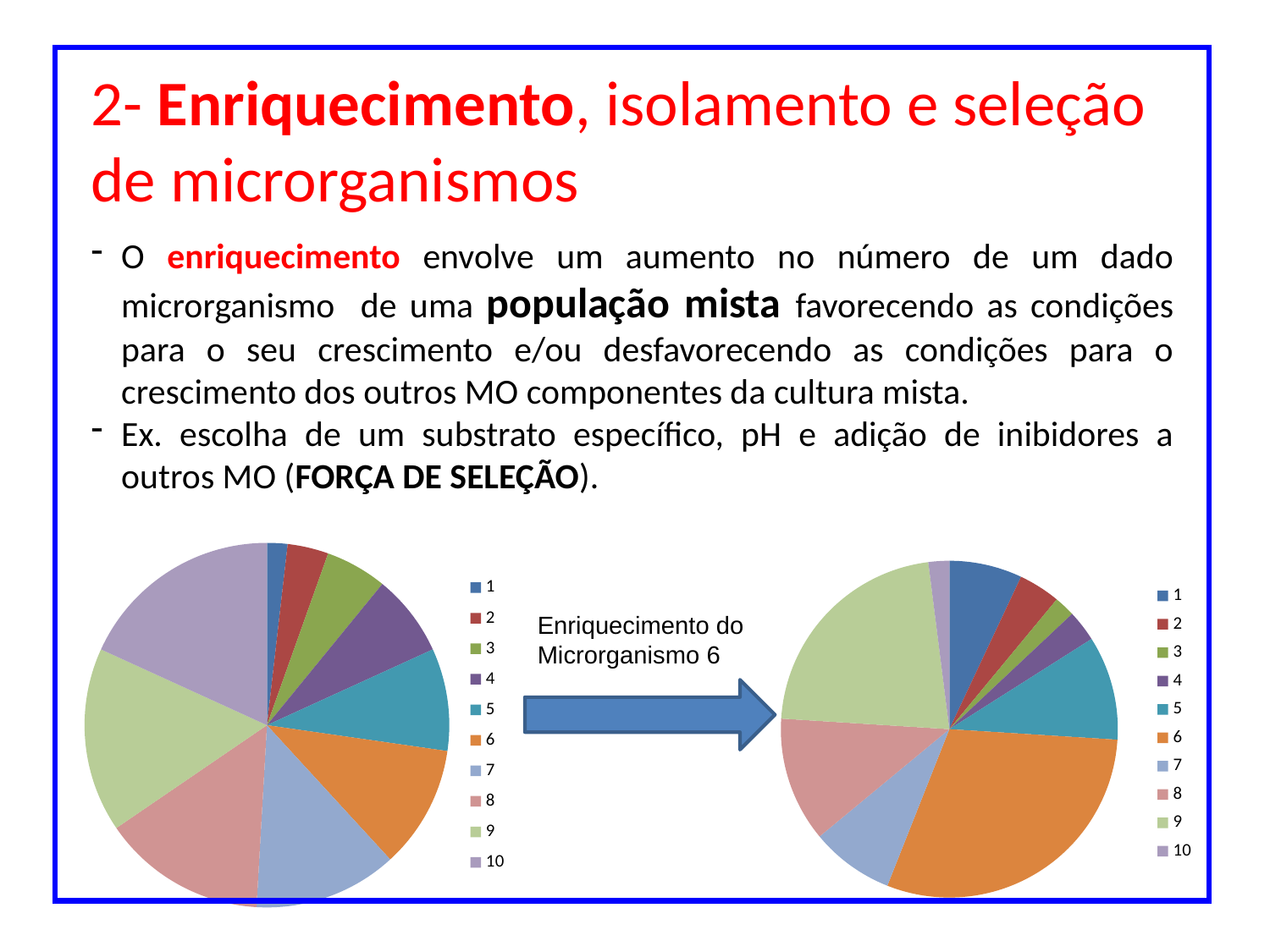
Is the slice for category 6 larger in the left pie chart or the right pie chart? right pie chart How many slices does the left pie chart have? 10 In the left pie chart, which category has the smallest slice? 1 What kind of chart is the left chart on the slide? pie chart How many slices does the right pie chart have? 10 In the right pie chart, which slice is larger, 9 or 3? 9 What text is written above the arrow between the two pie charts? Enriquecimento do Microrganismo 6 In the right pie chart, which category has the largest slice? 6 In the right pie chart, which slice is larger, 6 or 1? 6 What kind of chart is the right chart on the slide? pie chart How many entries does the legend of the right pie chart list? 10